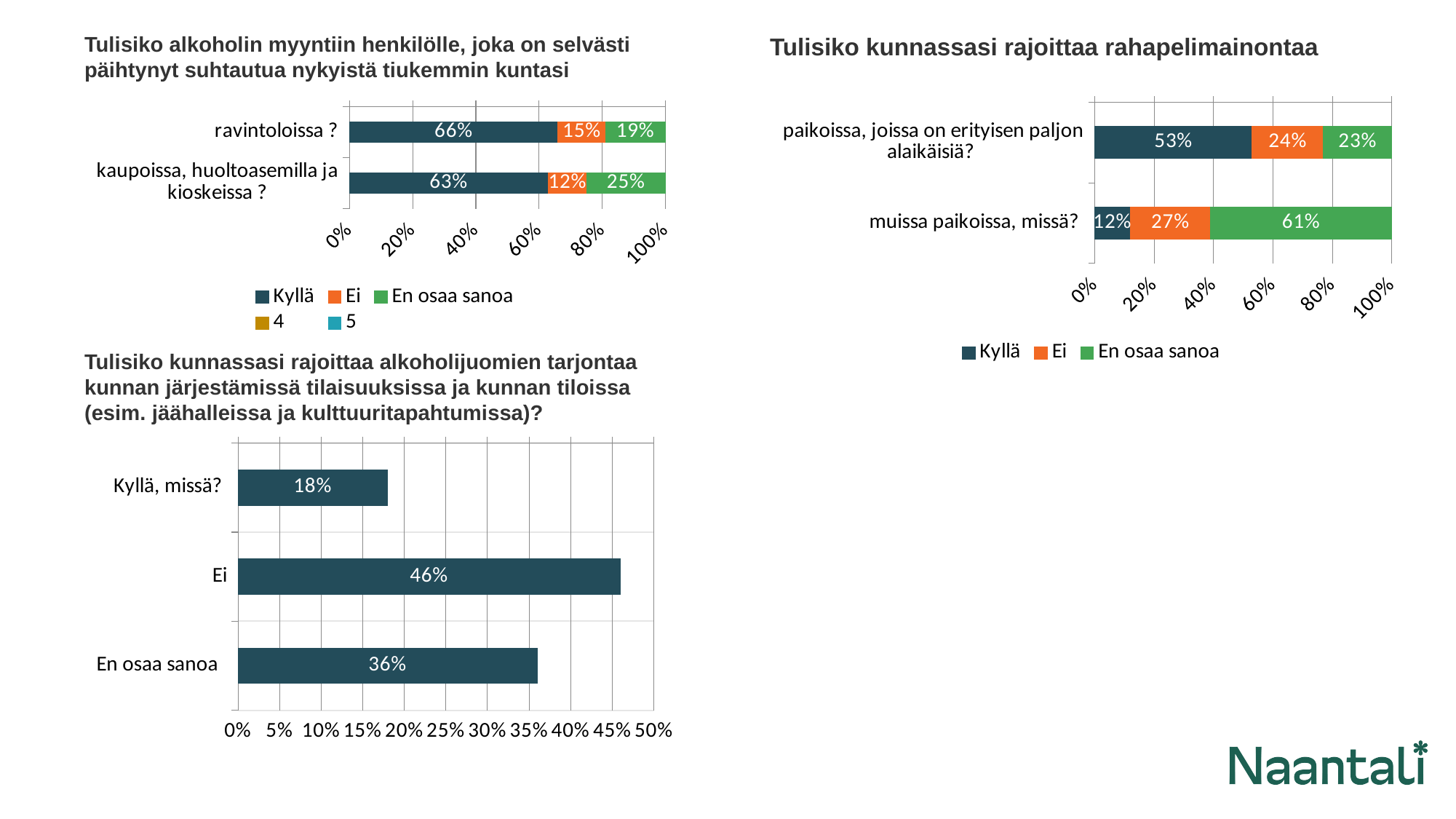
In the top-left chart (alcohol sales to clearly intoxicated persons), what is the 'Kyllä' value for 'ravintoloissa ?'? 66% In the top-left chart (alcohol sales to clearly intoxicated persons), what is the difference between the 'Ei' values for 'ravintoloissa ?' and 'kaupoissa, huoltoasemilla ja kioskeissa ?'? 3% In the chart titled 'Tulisiko kunnassasi rajoittaa rahapelimainontaa', what is the 'En osaa sanoa' value for 'muissa paikoissa, missä?'? 61% In the chart titled 'Tulisiko kunnassasi rajoittaa rahapelimainontaa', what is the total of the stacked bar for 'paikoissa, joissa on erityisen paljon alaikäisiä?'? 100% What kind of chart is the bottom-left chart (restricting alcohol at municipal events and premises)? bar chart In the bottom-left chart (restricting alcohol at municipal events and premises), what is the difference between 'Ei' and 'En osaa sanoa'? 10% How many entries does the legend of the top-left chart (alcohol sales to clearly intoxicated persons) list? 5 In the chart titled 'Tulisiko kunnassasi rajoittaa rahapelimainontaa', which category has the larger 'Ei' value? muissa paikoissa, missä? In the top-left chart (alcohol sales to clearly intoxicated persons), what is the 'En osaa sanoa' value for 'kaupoissa, huoltoasemilla ja kioskeissa ?'? 25% In the bottom-left chart (restricting alcohol at municipal events and premises), what is the value for 'Ei'? 46% In the chart titled 'Tulisiko kunnassasi rajoittaa rahapelimainontaa', what is the 'Kyllä' value for 'paikoissa, joissa on erityisen paljon alaikäisiä?'? 53% In the bottom-left chart (restricting alcohol at municipal events and premises), which category has the lowest value? Kyllä, missä?